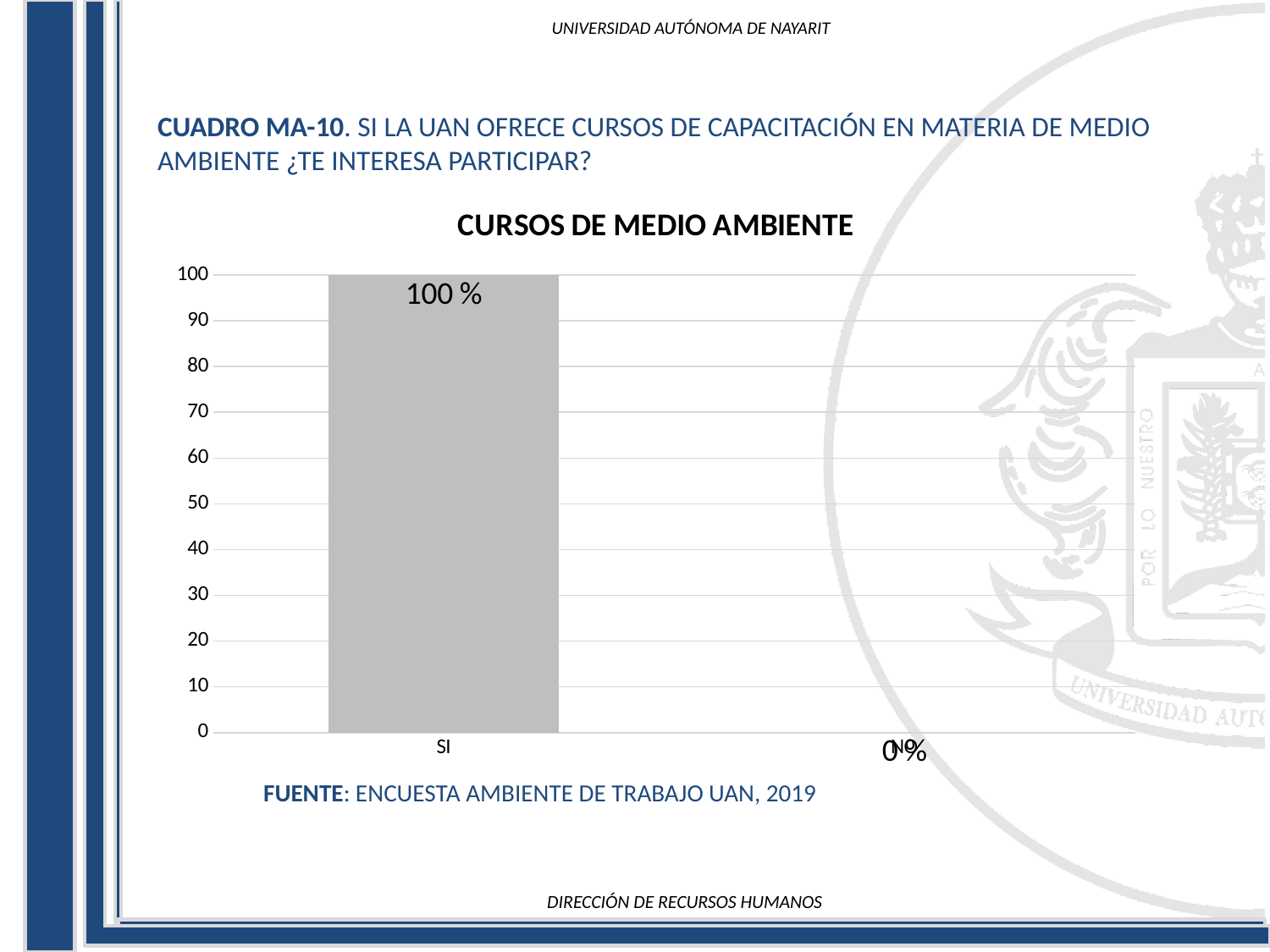
How many categories are shown on the x axis? 2 Which category has the lowest value? NO Is the value for SI greater or less than 50? greater What kind of chart is shown? bar chart What is the value for NO? 0% What is the title of the chart? CURSOS DE MEDIO AMBIENTE What is the value for SI? 100 % Which category has the highest value? SI What is the maximum value shown on the y axis? 100 Which is larger, the value for SI or the value for NO? SI What is the difference between the values for SI and NO? 100